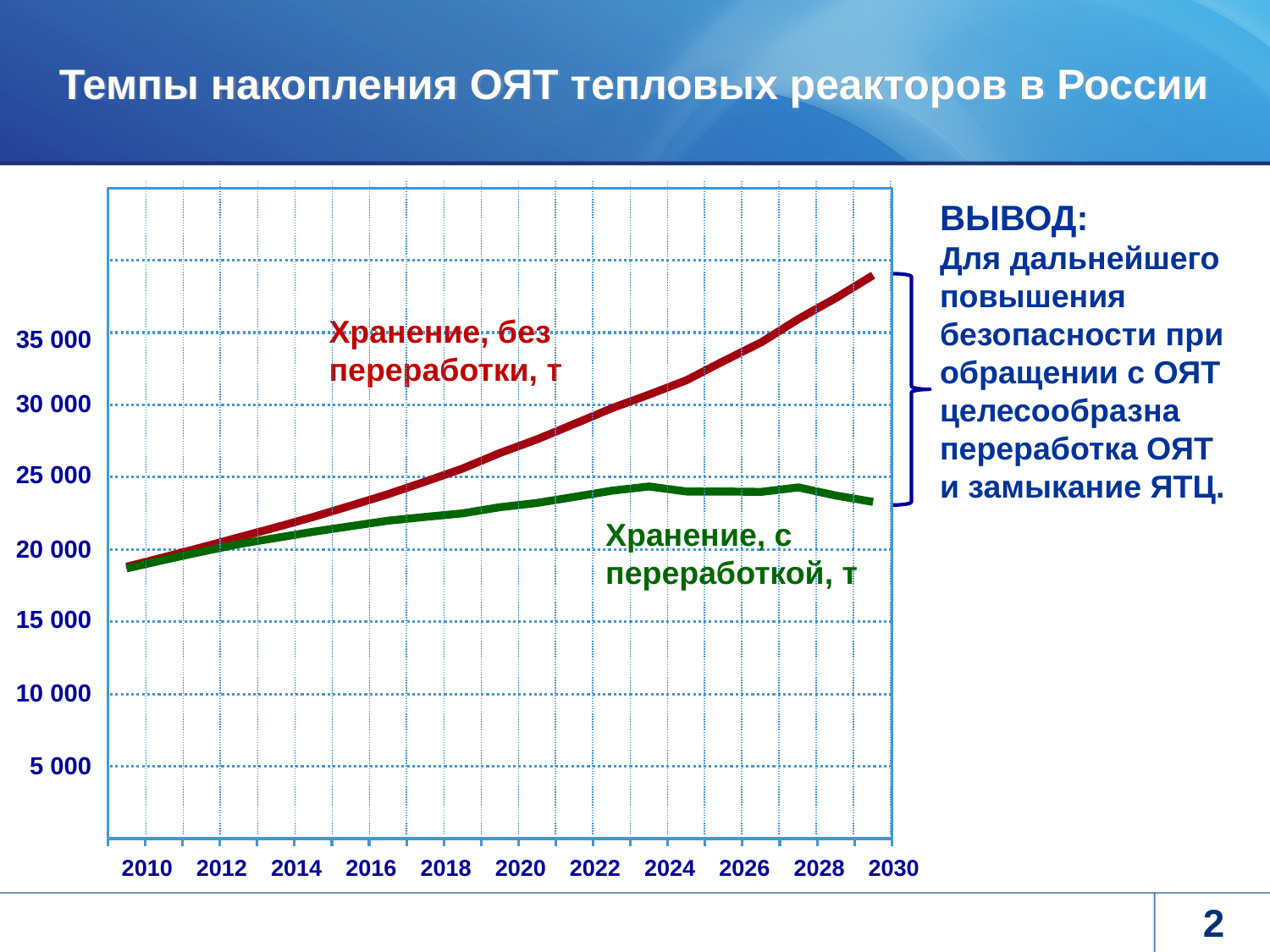
Is the value for "Хранение, с переработкой, т" in 2020 greater or less than 20 000? greater How many year labels are shown on the x axis? 11 In 2030, which series has the larger value: "Хранение, без переработки, т" or "Хранение, с переработкой, т"? Хранение, без переработки, т How many data series are plotted on the chart? 2 Is the value for "Хранение, без переработки, т" in 2020 greater or less than 25 000? greater Which colour is used for the series "Хранение, без переработки, т"? red What is the title of the slide's chart? Темпы накопления ОЯТ тепловых реакторов в России Is the value for "Хранение, без переработки, т" in 2030 greater or less than 35 000? greater What kind of chart is shown on the slide? line chart Does the value of "Хранение, без переработки, т" rise or fall from 2010 to 2030? rise